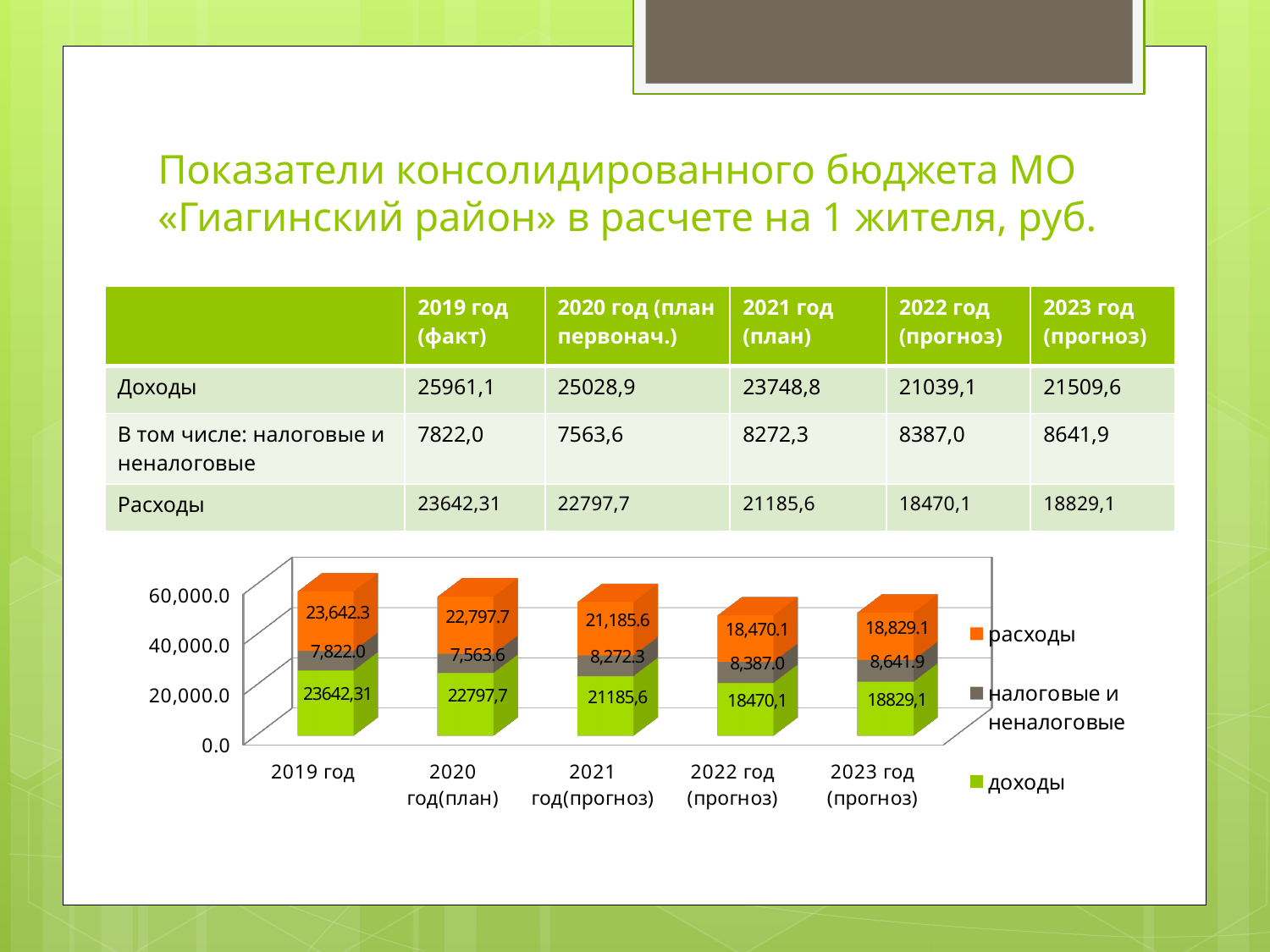
What is the value of доходы for 2021 год(прогноз) in the chart? 21185,6 How many series does the chart legend list? 3 What is the difference between the расходы values for 2019 год and 2020 год(план) in the chart? 844.6 How many categories (years) are shown on the x axis of the chart? 5 In which year is the расходы value the lowest in the chart? 2022 год (прогноз) Which is larger in the chart: налоговые и неналоговые for 2022 год (прогноз) or for 2020 год(план)? 2022 год (прогноз) What kind of chart is shown on the slide? bar chart From 2019 год to 2022 год (прогноз), do the расходы values rise or fall in the chart? fall What is the value of налоговые и неналоговые for 2023 год (прогноз) in the chart? 8,641.9 In which year is the расходы value the highest in the chart? 2019 год What is the value of расходы for 2019 год in the chart? 23,642.3